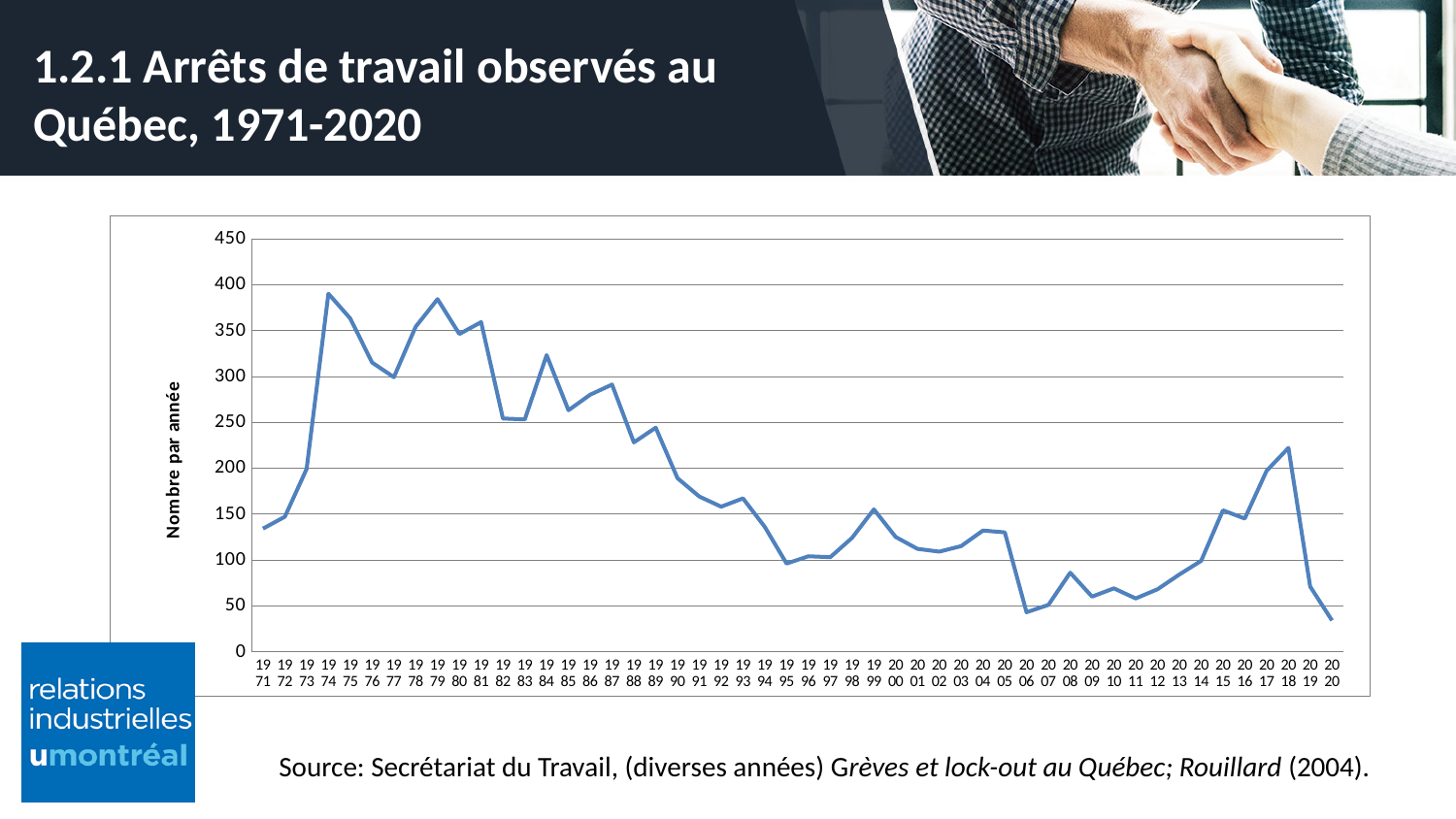
Is the value for 1971 greater or less than 150? less Which year has the larger value, 2018 or 2006? 2018 Is the value for 2020 greater or less than 50? less Is the value for 1987 greater or less than 250? greater What kind of chart is shown on the slide? line chart How many years (data points) are plotted along the x axis? 50 What is the label of the vertical axis? Nombre par année What is the highest value shown on the vertical axis? 450 Which year has the larger value, 1974 or 2020? 1974 Do the values rise or fall between 2014 and 2018? rise